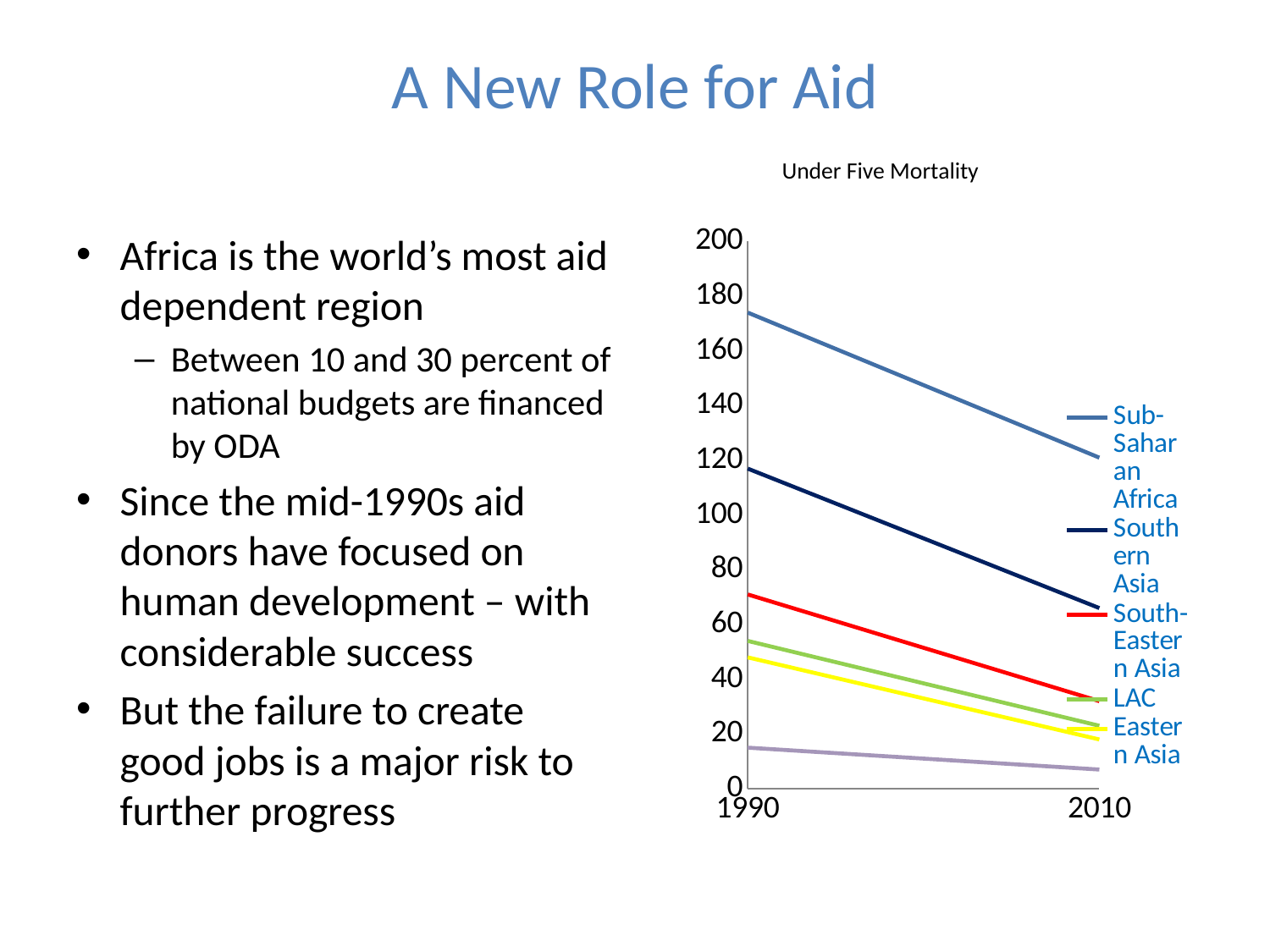
In 2010, which is larger: the value for Southern Asia or the value for South-Eastern Asia? Southern Asia What colour is the line for Eastern Asia in the chart? yellow What kind of chart is shown on the slide? line chart Is the value for Southern Asia in 2010 greater or less than 80? less How many series does the chart's legend list? 5 How many years are marked on the x axis of the chart? 2 Which region has the highest under-five mortality in 2010? Sub-Saharan Africa Does under-five mortality for Sub-Saharan Africa rise or fall from 1990 to 2010? fall Is the value for Sub-Saharan Africa in 1990 greater or less than 160? greater Is the value for South-Eastern Asia in 1990 greater or less than 60? greater Which region has the highest under-five mortality in 1990? Sub-Saharan Africa What is the title of the chart on the slide? Under Five Mortality